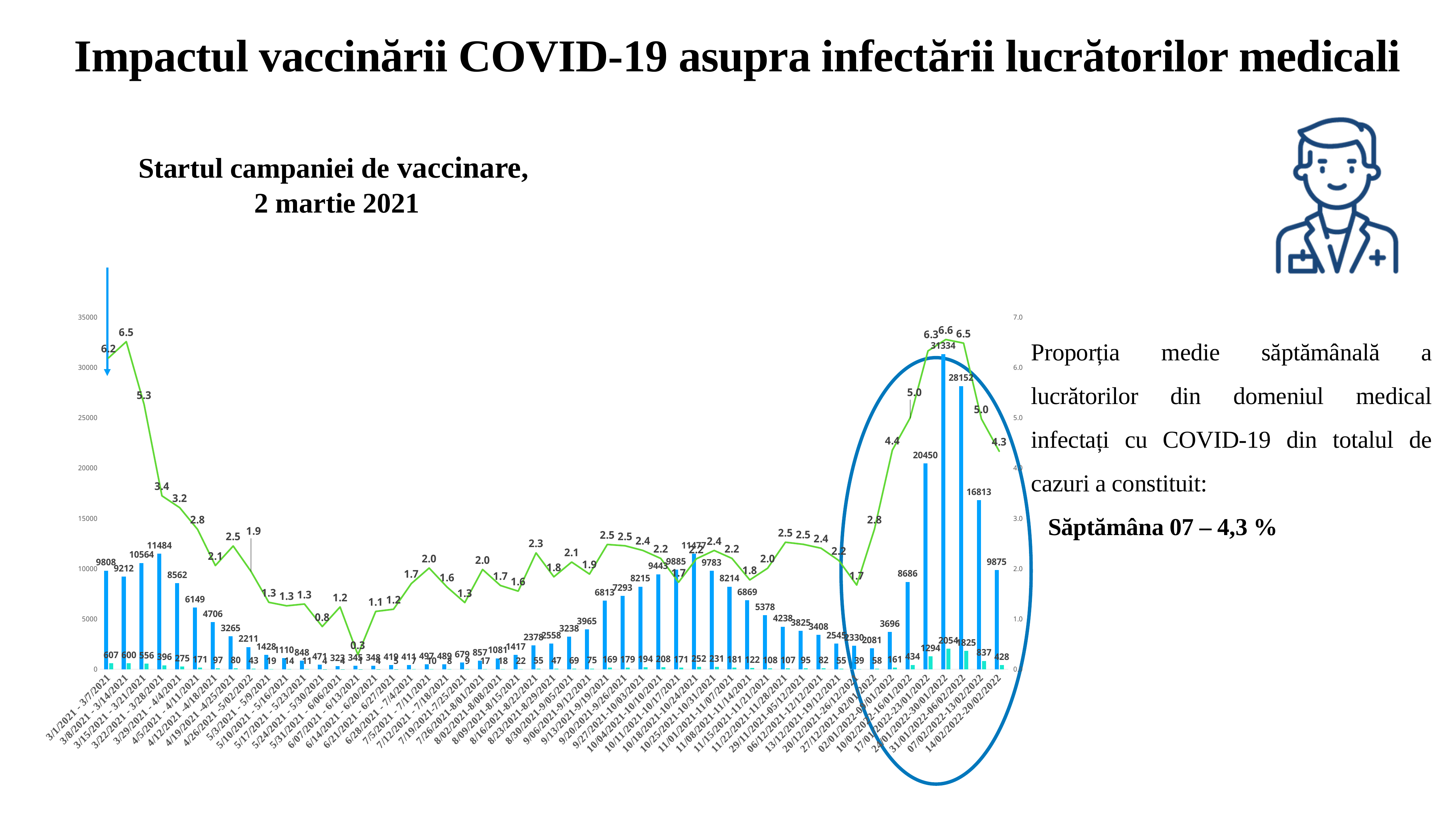
What is the highest value labelled on the green line? 6.6 What is the value of the tallest blue bar on the chart? 31334 What is the value of the first blue bar, for the week 3/1/2021 - 3/7/2021? 9808 What is the highest value labelled on the small teal bars? 2054 What is the lowest value labelled on the green line? 0.3 What is the last value labelled on the green line, at the right end of the chart? 4.3 Does the green line rise or fall over the first few weeks from 6.5 to 1.9? fall What is the difference between the two tallest blue bars, 31334 and 28152? 3182 Which is larger: the blue bar labelled 20450 or the blue bar labelled 16813? 20450 What is the top tick value on the left vertical axis? 35000 What kind of chart is shown: a bar chart, a line chart, or a combination of bars and a line? combination of bars and a line What is the value of the last blue bar, for the week 14/02/2022-20/02/2022? 9875